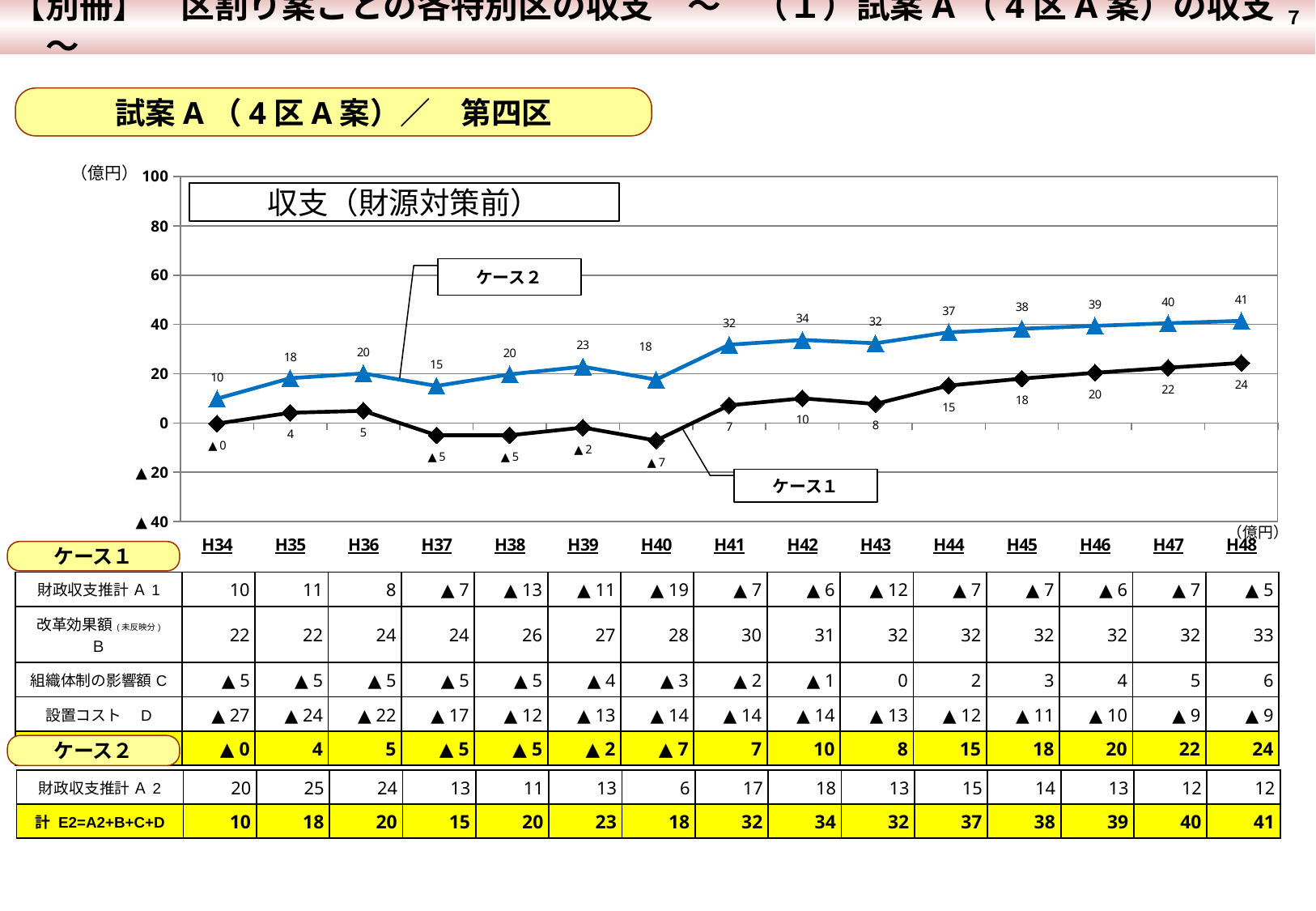
In which year does ケース2 reach its highest value? H48 What is the title shown inside the chart area? 収支（財源対策前） In which year is ケース1 at its lowest value? H40 What type of chart is shown on the slide? line chart What is the value for ケース1 in H48? 24 What is the value for ケース1 in H40? ▲7 What is the value for ケース2 in H42? 34 Which series has the larger value in H41, ケース1 or ケース2? ケース2 How many series are plotted in the chart? 2 What is the difference between ケース2 and ケース1 in H48? 17 Is the value for ケース2 in H45 greater or less than 20? greater How many years (points) are plotted along the x axis of the chart? 15